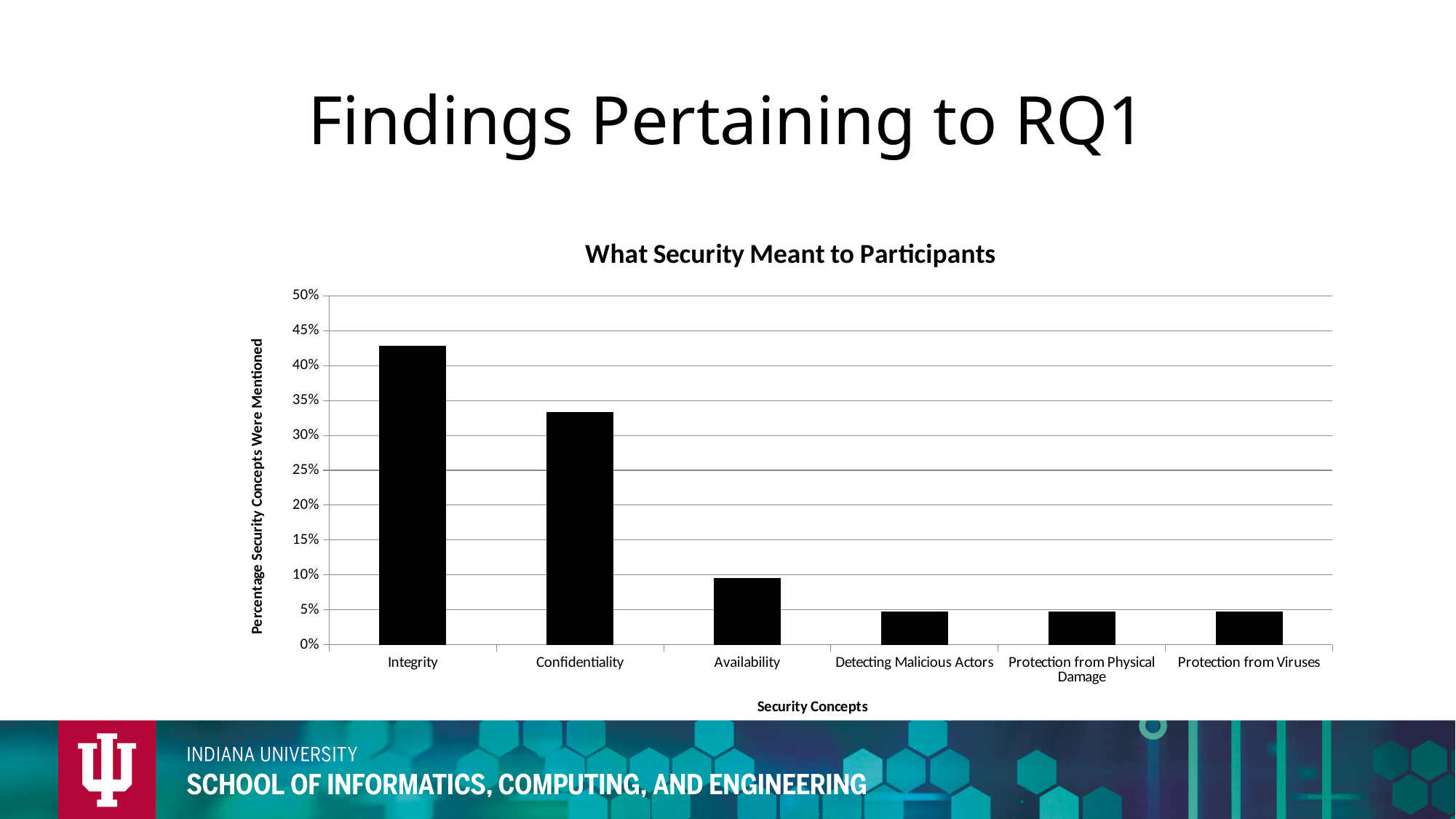
What kind of chart is shown on the slide? bar chart What is the title of the chart? What Security Meant to Participants Which is larger, the value for Integrity or the value for Confidentiality? Integrity What is the label on the y axis of the chart? Percentage Security Concepts Were Mentioned How many security concepts are shown on the x axis of the chart? 6 Is the value for Integrity greater or less than 40%? greater Is the value for Confidentiality greater or less than 30%? greater Which is larger, the value for Confidentiality or the value for Availability? Confidentiality Which security concept has the highest percentage in the chart? Integrity Do the values rise or fall moving from left to right along the x axis? fall